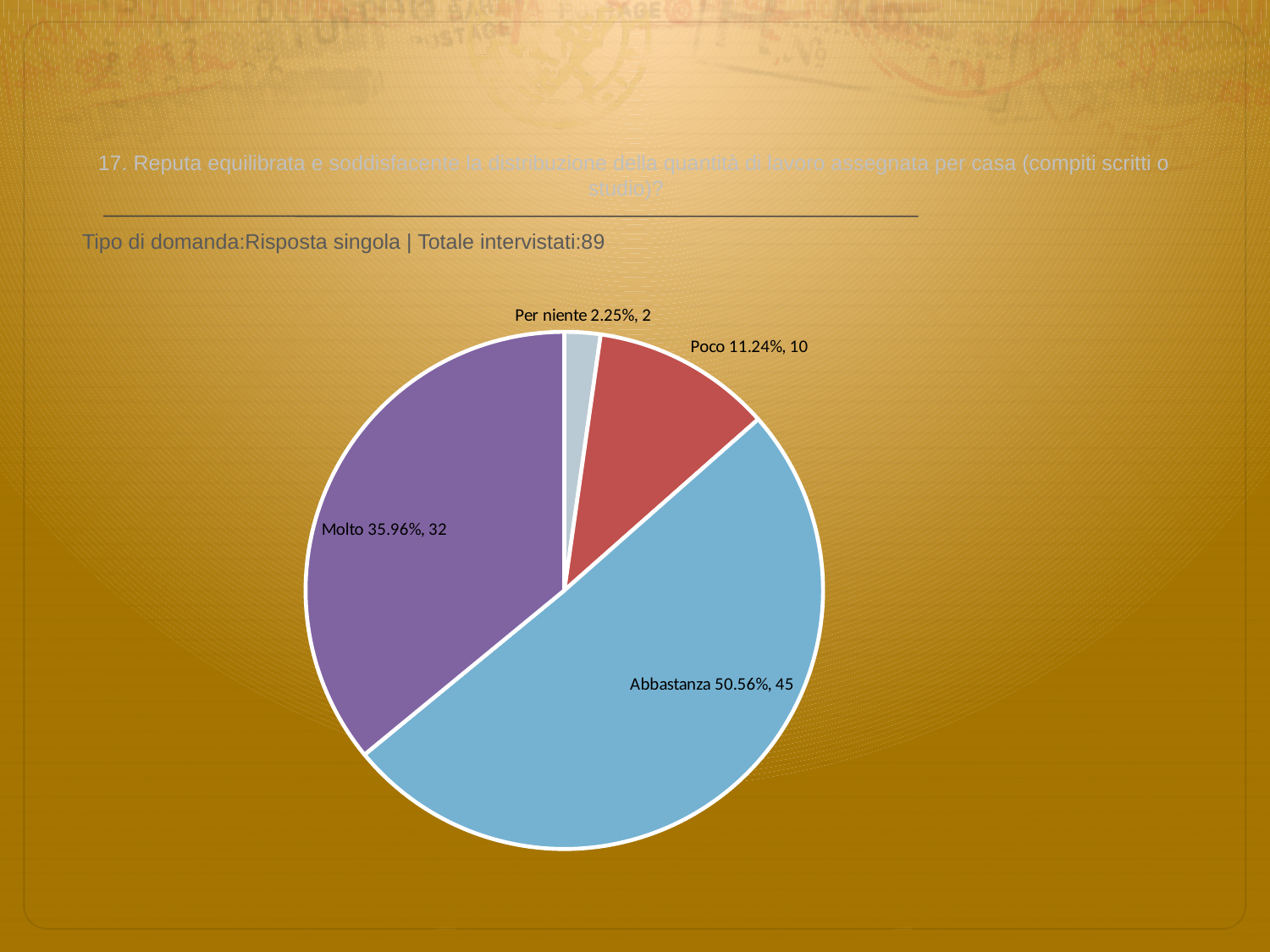
Which response has the smallest share of the pie? Per niente What percentage of respondents answered "Abbastanza"? 50.56% How many respondents answered "Per niente"? 2 Which has more respondents, "Poco" or "Per niente"? Poco What colour is the "Molto" slice of the pie? purple How many respondents answered "Molto"? 32 What kind of chart is shown on the slide? pie chart What percentage of respondents answered "Poco"? 11.24% How many slices does the pie chart have? 4 Which response has the largest share of the pie? Abbastanza What is the total number of respondents shown on the slide? 89 What is the difference in number of respondents between "Abbastanza" and "Molto"? 13